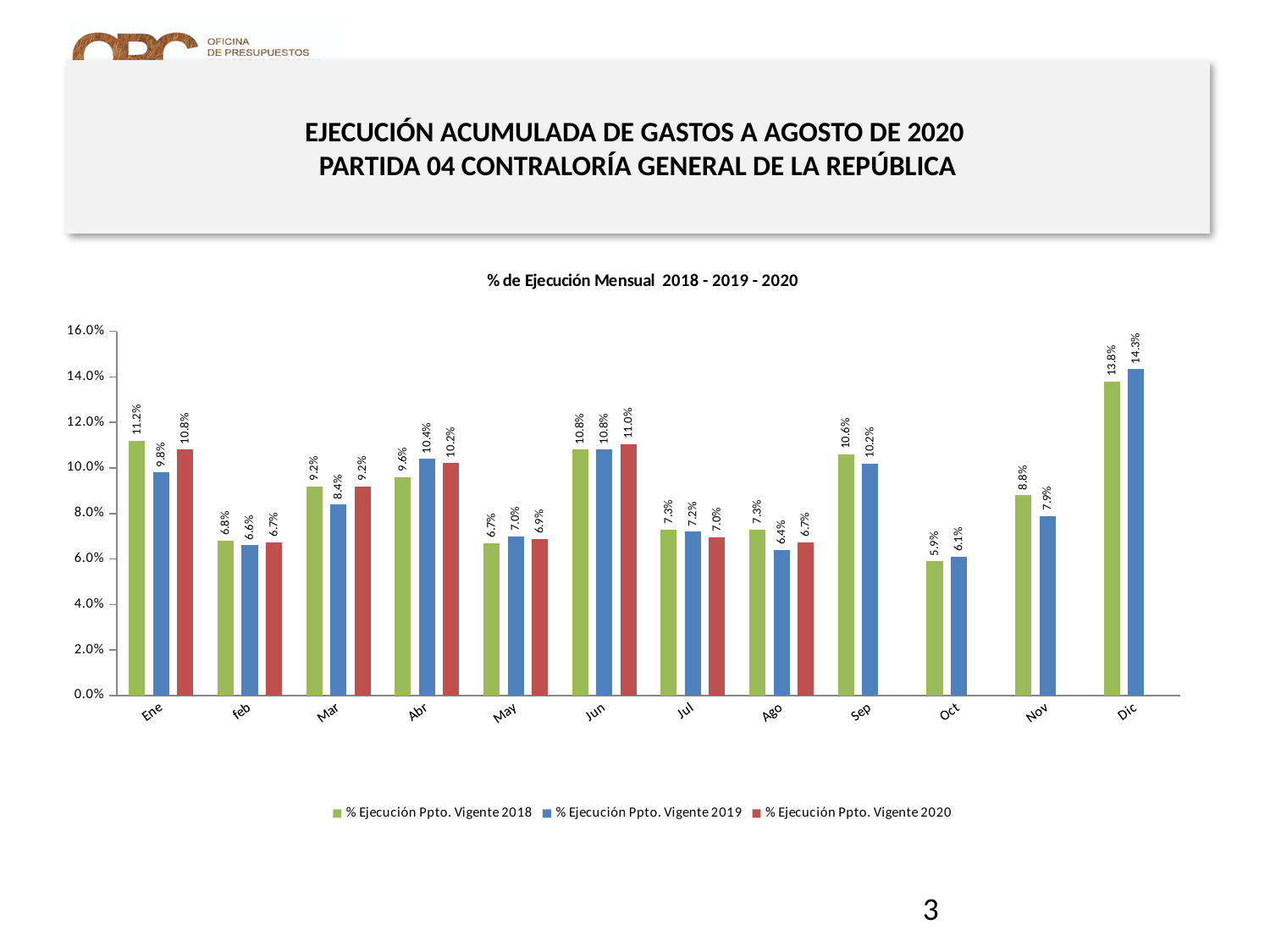
Which month has the highest value for % Ejecución Ppto. Vigente 2019? Dic What is the value for % Ejecución Ppto. Vigente 2020 in Jun? 11.0% What is the value for % Ejecución Ppto. Vigente 2019 in Dic? 14.3% How many series does the legend list? 3 What kind of chart is shown on the slide? Bar chart Which month has the lowest value for % Ejecución Ppto. Vigente 2018? Oct What is the difference between the 2018 and 2019 values in Ene? 1.4% How many months are shown on the x axis? 12 What is the title of the chart? % de Ejecución Mensual 2018 - 2019 - 2020 What is the value for % Ejecución Ppto. Vigente 2018 in Ene? 11.2% Is the value for % Ejecución Ppto. Vigente 2018 in Dic greater or less than 12.0%? greater Which is larger in Abr: the 2018 value or the 2019 value? 2019